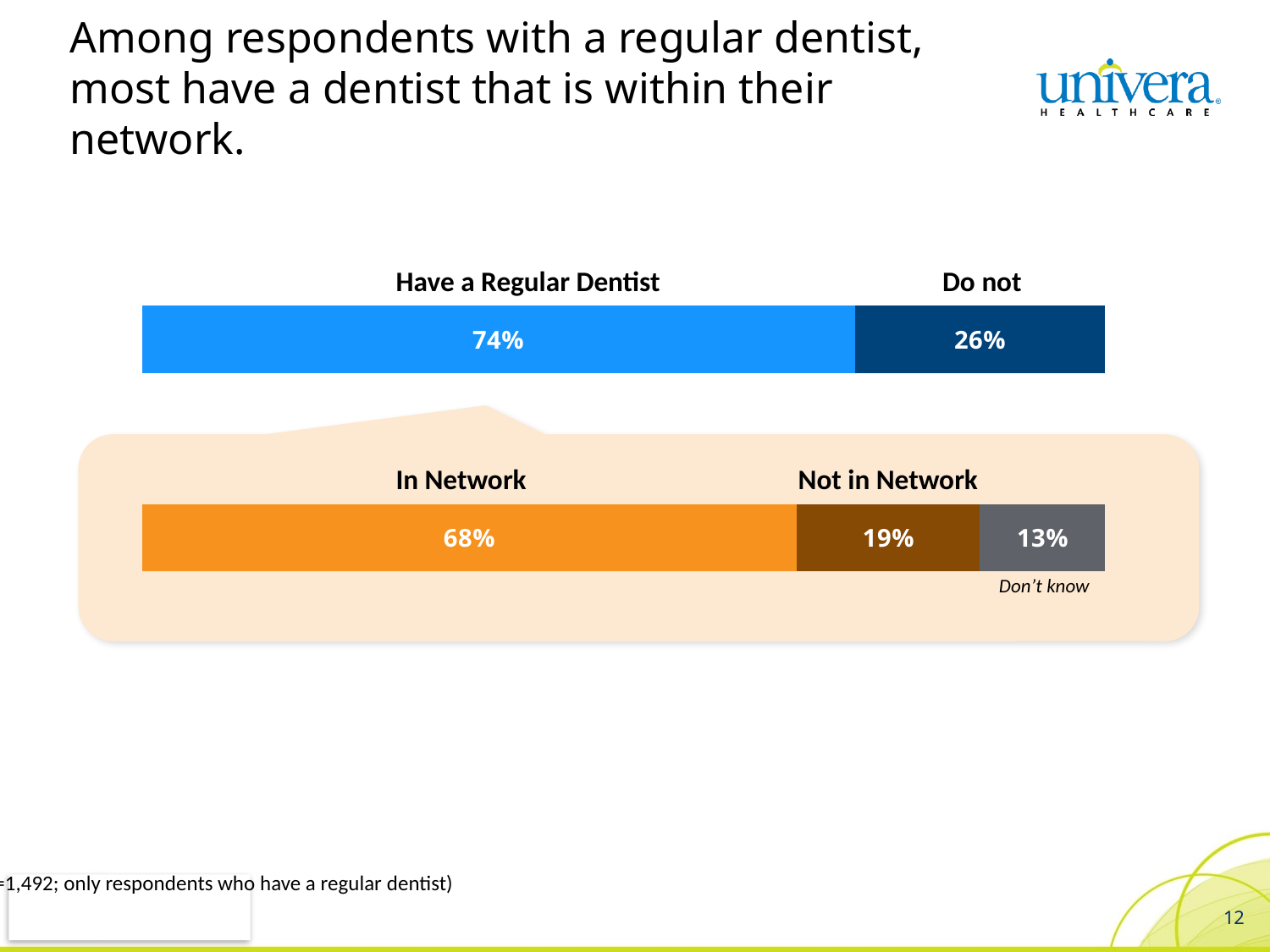
In the bottom bar, which is larger: Not in Network or Don't know? Not in Network In the bottom bar, what is the difference between the In Network share and the Not in Network share? 49% In the top bar, what is the difference between the share that have a regular dentist and the share that do not? 48% In the bottom bar, which category has the smallest share? Don't know How many segments does the bottom bar have? 3 In the top bar, what percentage of respondents do not have a regular dentist? 26% In the bottom bar, what percentage of respondents have a dentist that is not in network? 19% What kind of chart is used on this slide? Stacked bar chart In the top bar, what percentage of respondents have a regular dentist? 74% In the bottom bar, what percentage of respondents have a dentist that is in network? 68% In the bottom bar, which category has the largest share? In Network In the bottom bar, what percentage of respondents answered 'Don't know'? 13%